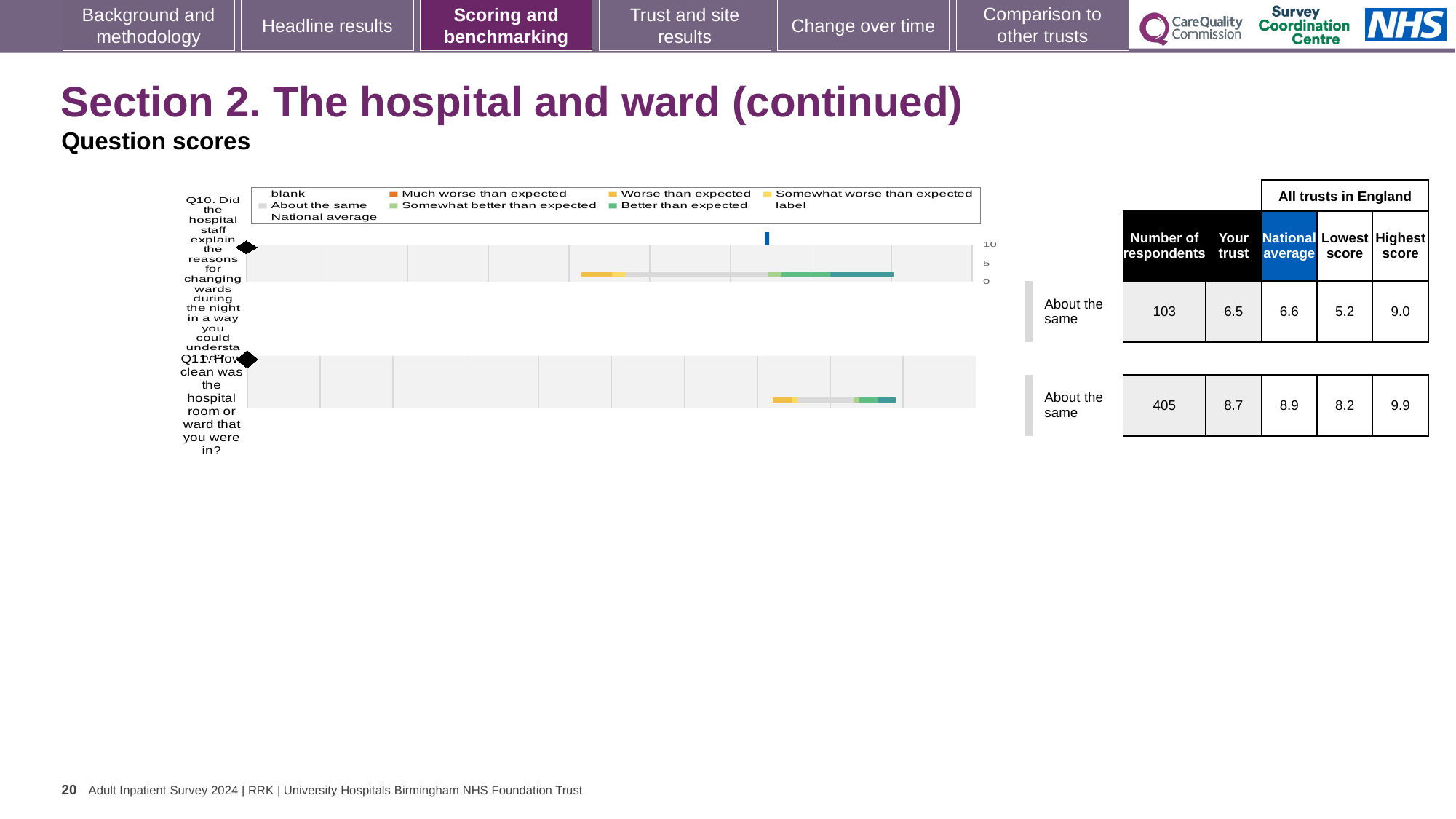
What is the 'Your trust' score for Q10 (explaining reasons for changing wards during the night)? 6.5 What is the difference between the highest and lowest scores for Q11? 1.7 What kind of chart is used to show the question scores on this slide? bar chart Which question has the higher 'Your trust' score, Q10 or Q11? Q11 What is the 'Your trust' score for Q11 (how clean was the hospital room or ward)? 8.7 How many respondents answered Q11? 405 What benchmark category is shown for Q11? About the same What is the national average score for Q10? 6.6 What is the difference between the highest and lowest scores for Q10? 3.8 How many questions are plotted in the chart? 2 For Q10, which is larger: the trust's score or the national average? national average What is the lowest score among all trusts in England for Q11? 8.2